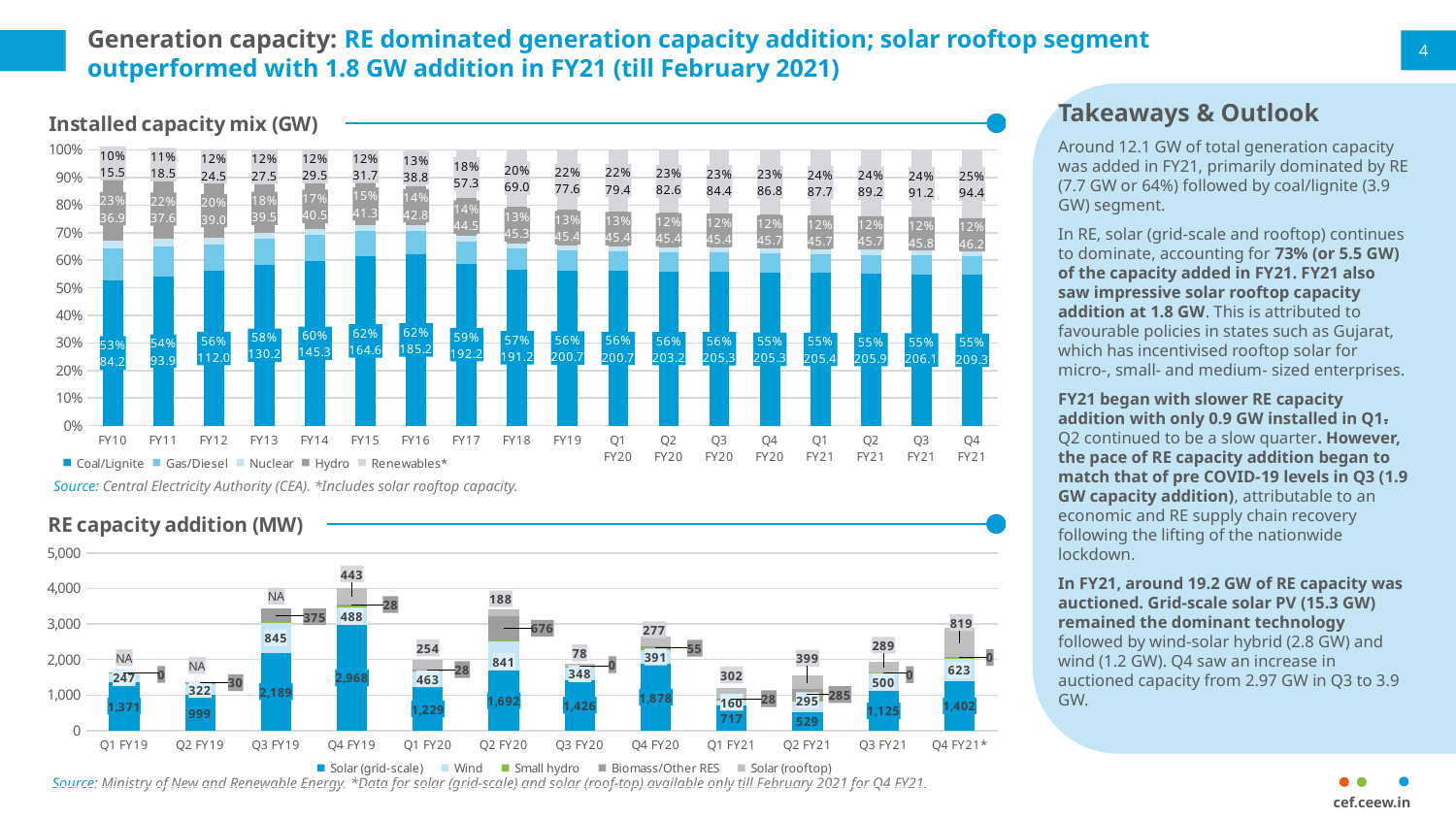
In the 'Installed capacity mix (GW)' chart, what percentage share do Renewables have in Q4 FY21? 25% In the 'RE capacity addition (MW)' chart, which is larger: the Wind addition in Q3 FY19 or in Q4 FY19? Q3 FY19 In the 'RE capacity addition (MW)' chart, what is the Solar (grid-scale) value for Q4 FY19? 2,968 In the 'Installed capacity mix (GW)' chart, what is the difference between the Coal/Lignite capacity in Q4 FY21 and in FY10? 125.1 How many series does the legend of the 'Installed capacity mix (GW)' chart list? 5 How many quarters are shown on the x axis of the 'RE capacity addition (MW)' chart? 12 In the 'Installed capacity mix (GW)' chart, does the Renewables share rise or fall from FY10 to Q4 FY21? Rise In the 'RE capacity addition (MW)' chart, which quarter has the highest Solar (grid-scale) addition? Q4 FY19 What kind of chart is the 'RE capacity addition (MW)' chart? Stacked bar chart In the 'RE capacity addition (MW)' chart, which quarter has the lowest Solar (grid-scale) addition? Q2 FY21 In the 'Installed capacity mix (GW)' chart, what is the Coal/Lignite capacity in FY10? 84.2 In the 'RE capacity addition (MW)' chart, is the total bar height for Q4 FY19 greater or less than 3,000? greater